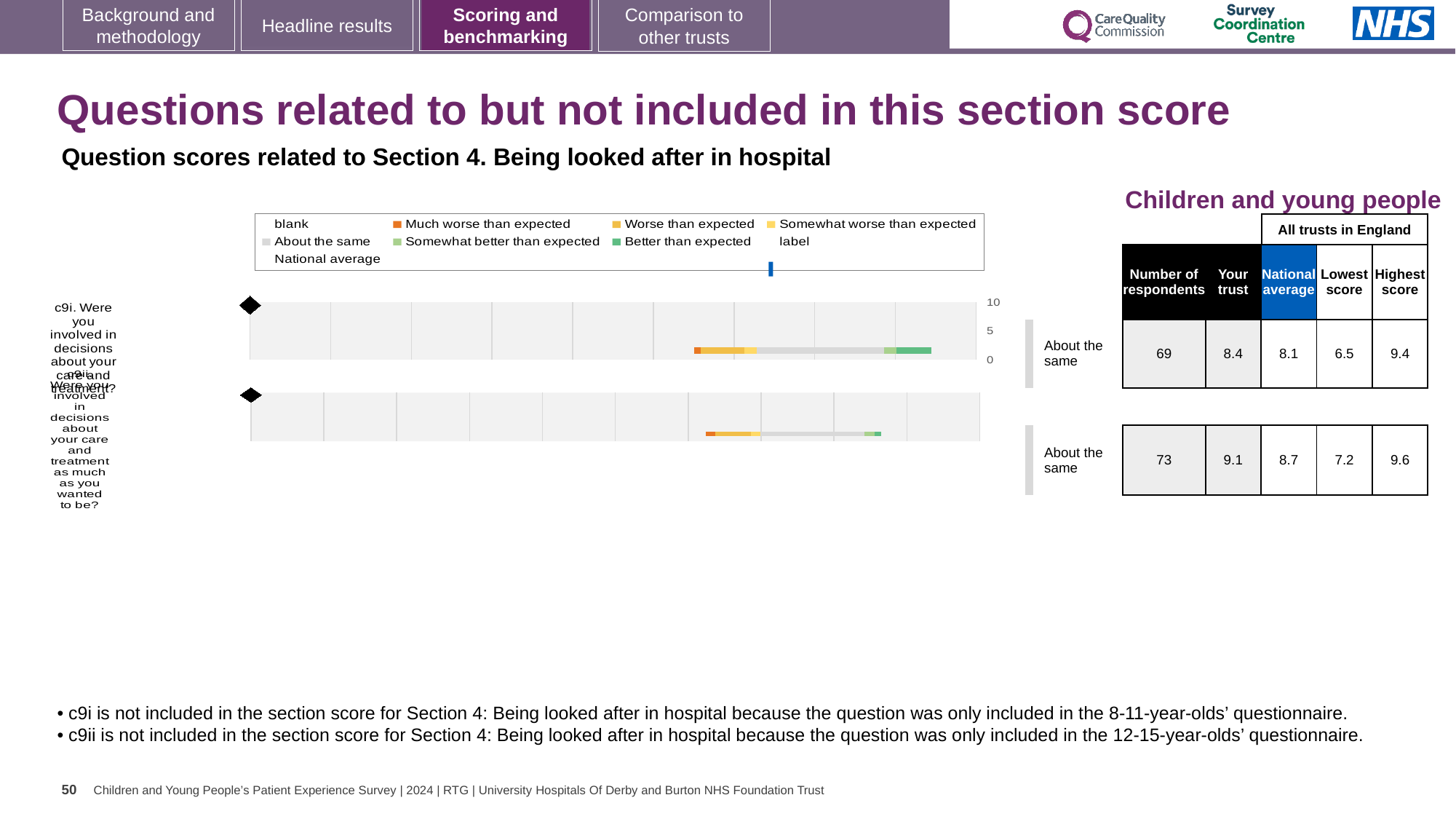
How many questions are plotted in the benchmarking chart? 2 What is the lowest score among all trusts in England for question c9i? 6.5 By how much does the trust's score for c9ii exceed the national average? 0.4 How many respondents answered question c9i? 69 What kind of chart is used to show the question scores? Bar chart For question c9i, which is higher: the trust's score or the national average? Your trust (8.4) What is the difference between the highest and lowest scores for question c9i? 2.9 What is the highest score among all trusts in England for question c9ii? 9.6 Which question had more respondents, c9i or c9ii? c9ii (73) What is the national average score for question c9ii? 8.7 What benchmark category is shown next to the chart for question c9ii? About the same What is the 'Your trust' score for question c9i (Were you involved in decisions about your care and treatment?)? 8.4